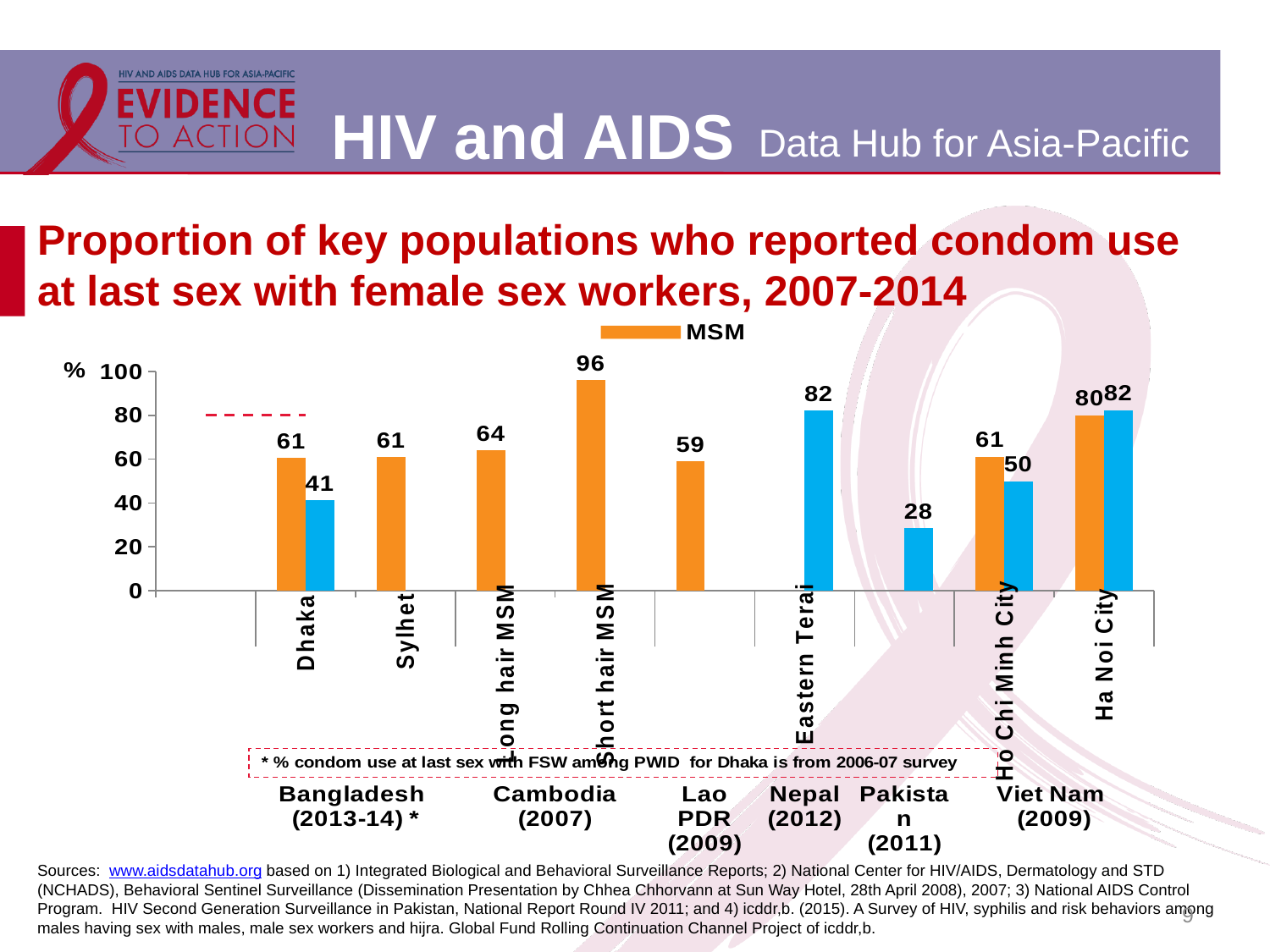
Which category has the highest value on the chart? Short hair MSM What is the MSM value for Dhaka? 61 What type of chart is shown on the slide? bar chart Which category has the lowest value on the chart? Pakistan (2011) What is the value of the blue bar for Dhaka? 41 What is the value shown for Eastern Terai in Nepal? 82 What is the value shown for Pakistan (2011)? 28 What is the MSM value for Short hair MSM in Cambodia? 96 What is the difference between the MSM value and the blue bar value for Dhaka? 20 Which series is named in the chart legend? MSM What is the difference between the MSM values for Short hair MSM and Long hair MSM in Cambodia? 32 Which is larger: the MSM value for Ho Chi Minh City or the blue bar for Ho Chi Minh City? MSM value for Ho Chi Minh City